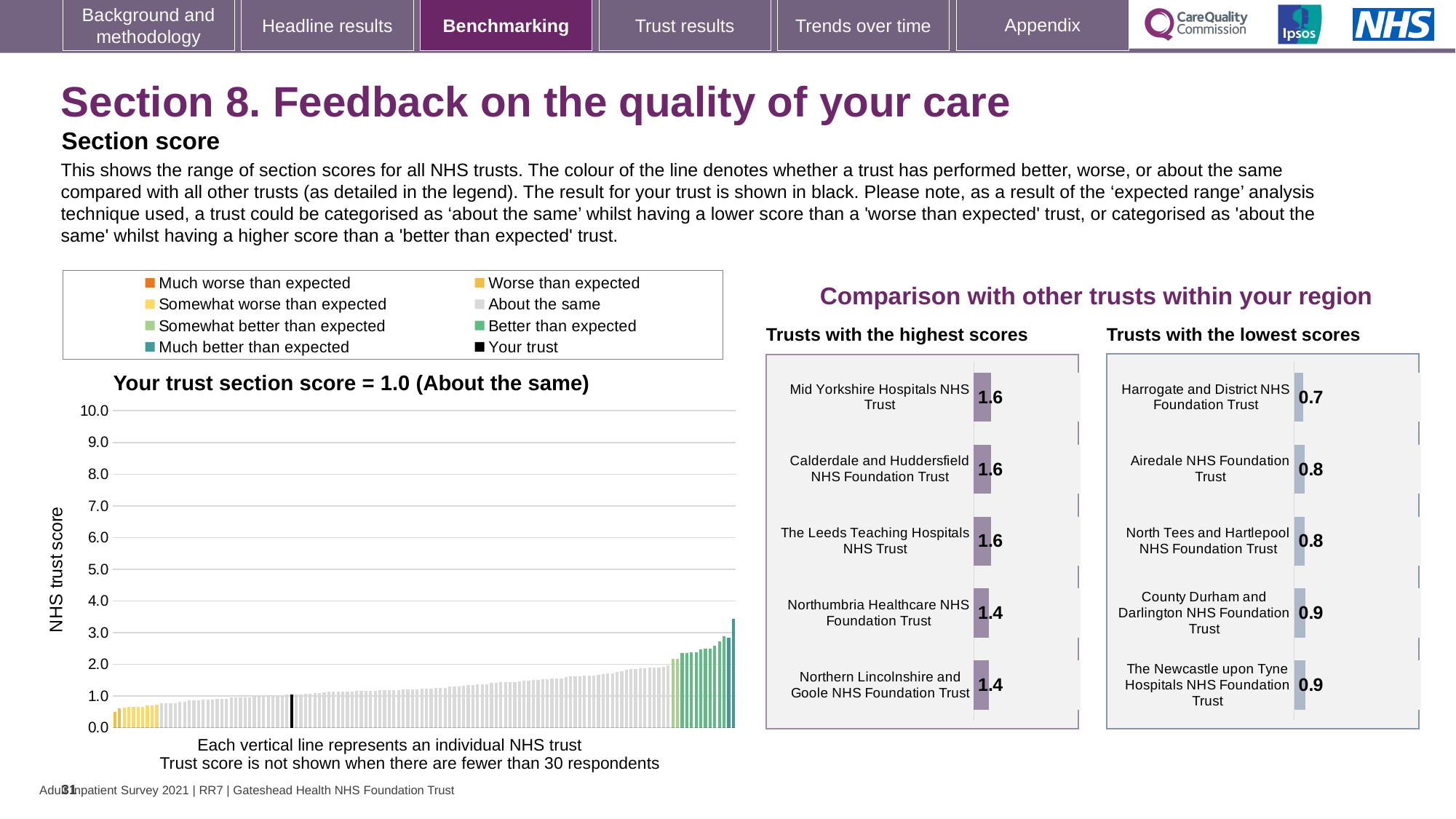
In the 'Trusts with the lowest scores' chart, what is the score for Airedale NHS Foundation Trust? 0.8 In the 'Trusts with the lowest scores' chart, which has the larger score: Harrogate and District NHS Foundation Trust or The Newcastle upon Tyne Hospitals NHS Foundation Trust? The Newcastle upon Tyne Hospitals NHS Foundation Trust In the 'Your trust section score' chart, what is the section score for your trust? 1.0 In the 'Trusts with the highest scores' chart, what is the score for Northumbria Healthcare NHS Foundation Trust? 1.4 In the 'Trusts with the highest scores' chart, what is the difference between the scores of Mid Yorkshire Hospitals NHS Trust and Northern Lincolnshire and Goole NHS Foundation Trust? 0.2 How many entries does the legend above the 'Your trust section score' chart list? 8 What kind of chart is the 'Your trust section score' chart? bar chart In the 'Your trust section score' chart, do the trust scores rise or fall from left to right? rise In the 'Your trust section score' chart, what category is your trust placed in? About the same In the 'Trusts with the highest scores' chart, how many trusts are shown? 5 In the 'Your trust section score' chart, is the value of the tallest bar greater or less than 3.0? greater In the 'Trusts with the lowest scores' chart, which trust has the lowest score? Harrogate and District NHS Foundation Trust